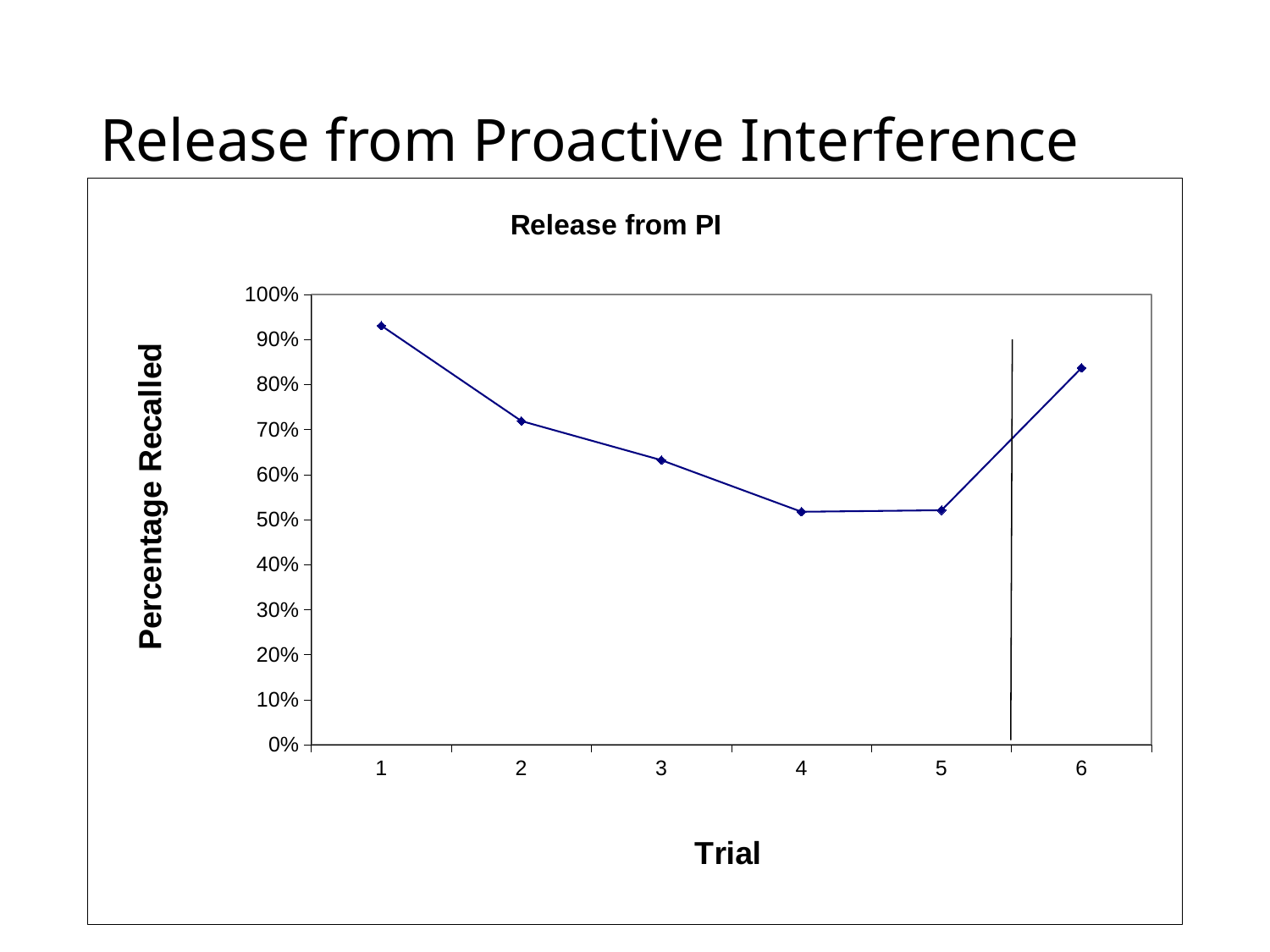
Is the percentage recalled for trial 4 greater or less than 60%? less How many trials are plotted on the x axis? 6 What is the title of the chart? Release from PI Is the percentage recalled for trial 6 greater or less than 80%? greater Which trial has the highest percentage recalled? Trial 1 Which has a higher percentage recalled, trial 1 or trial 6? Trial 1 Is the percentage recalled for trial 2 greater or less than 80%? less What kind of chart is shown on the slide? line chart Which has a higher percentage recalled, trial 5 or trial 6? Trial 6 Do the values rise or fall from trial 1 to trial 4? fall